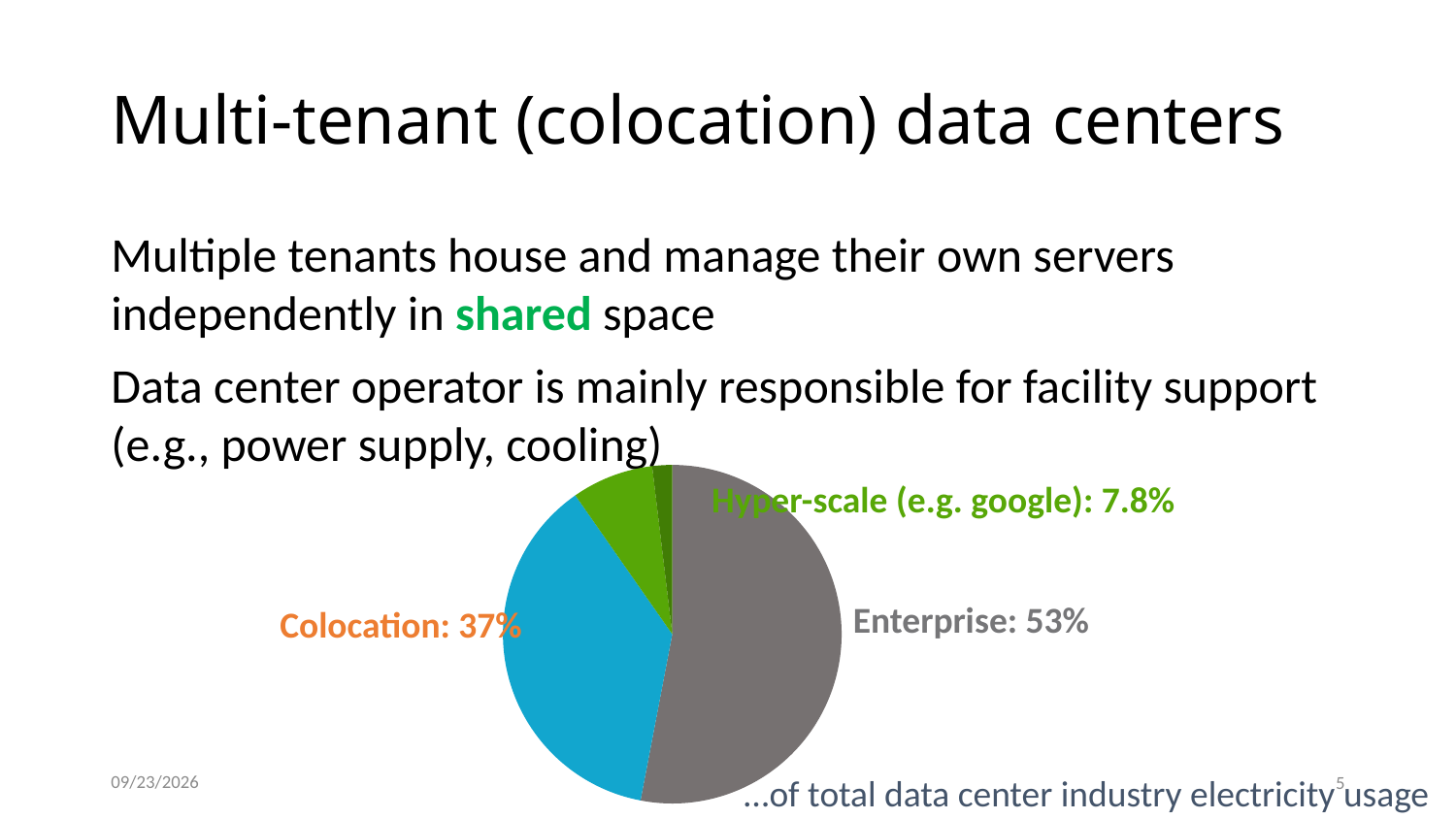
Is the Enterprise share greater or less than 50%? greater What is the difference in percentage points between the Colocation share and the Hyper-scale share? 29.2 What kind of chart is shown on the slide? pie chart What share of total data center industry electricity usage is attributed to Hyper-scale data centers? 7.8% What is the difference in percentage points between the Enterprise share and the Colocation share? 16 Which labeled category has the smallest share of the pie? Hyper-scale (e.g. google) Which labeled category has the largest share of the pie? Enterprise What share of total data center industry electricity usage is attributed to Enterprise data centers? 53% What colour is the Colocation slice of the pie chart? blue Which is larger, the Colocation share or the Hyper-scale share? Colocation How many categories in the pie chart have a printed label with a percentage? 3 What share of total data center industry electricity usage is attributed to Colocation data centers? 37%